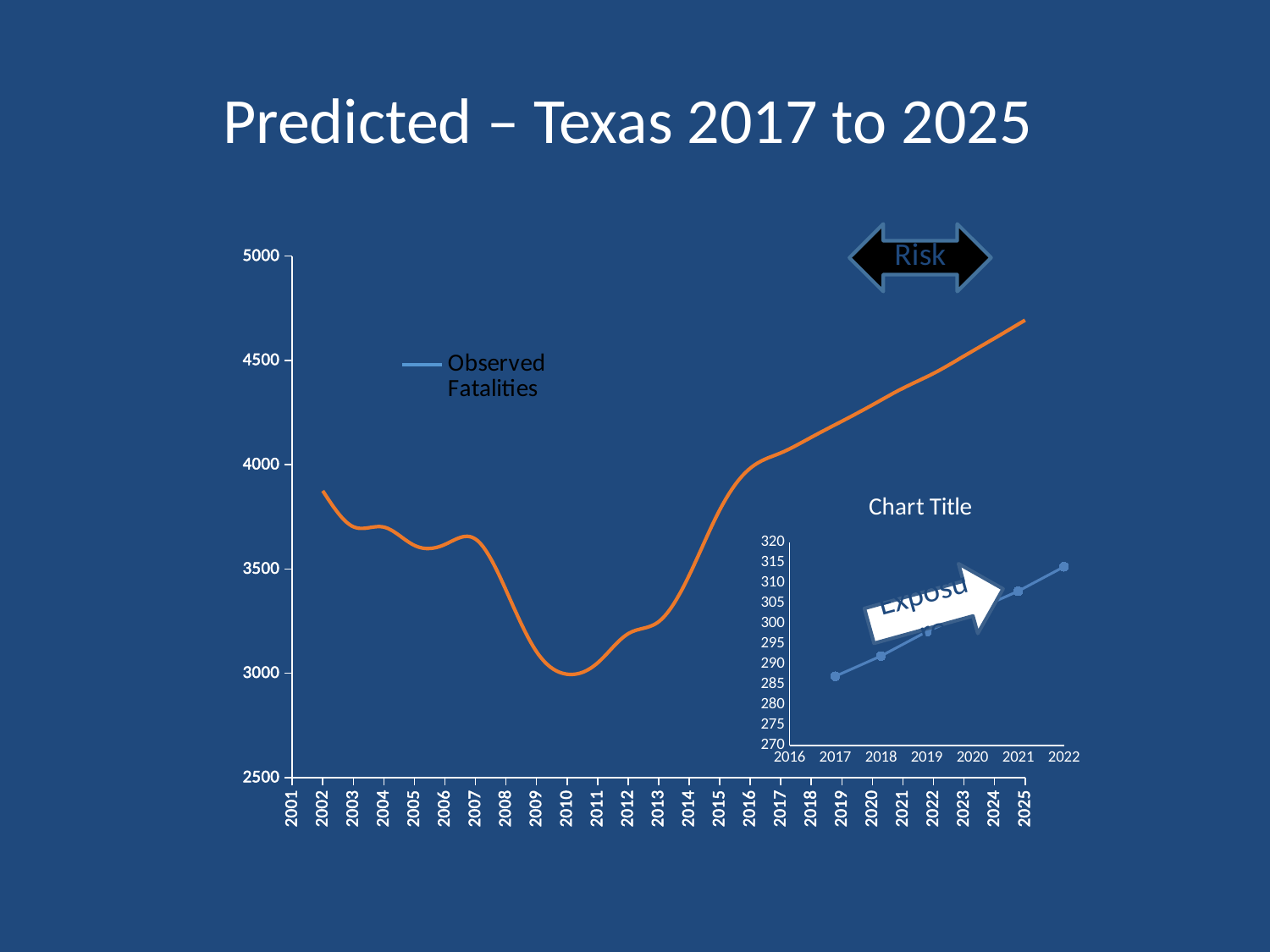
In the large chart on the left, which year has the highest value? 2025 In the large chart on the left, which year has the lowest value? 2010 In the large chart on the left, is the value for 2025 greater or less than 4500? greater What series name does the legend of the large chart on the left show? Observed Fatalities In the large chart on the left, do the values rise or fall from 2016 to 2025? rise What type of chart is the large chart on the left? line chart In the large chart on the left, is the value for 2010 greater or less than 3500? less In the large chart on the left, is the value for 2002 greater or less than 4000? less In the large chart on the left, which year has the larger value, 2002 or 2007? 2002 In the small inset chart titled 'Chart Title', do the values rise or fall from 2017 to 2022? rise In the large chart on the left, which year has the larger value, 2013 or 2016? 2016